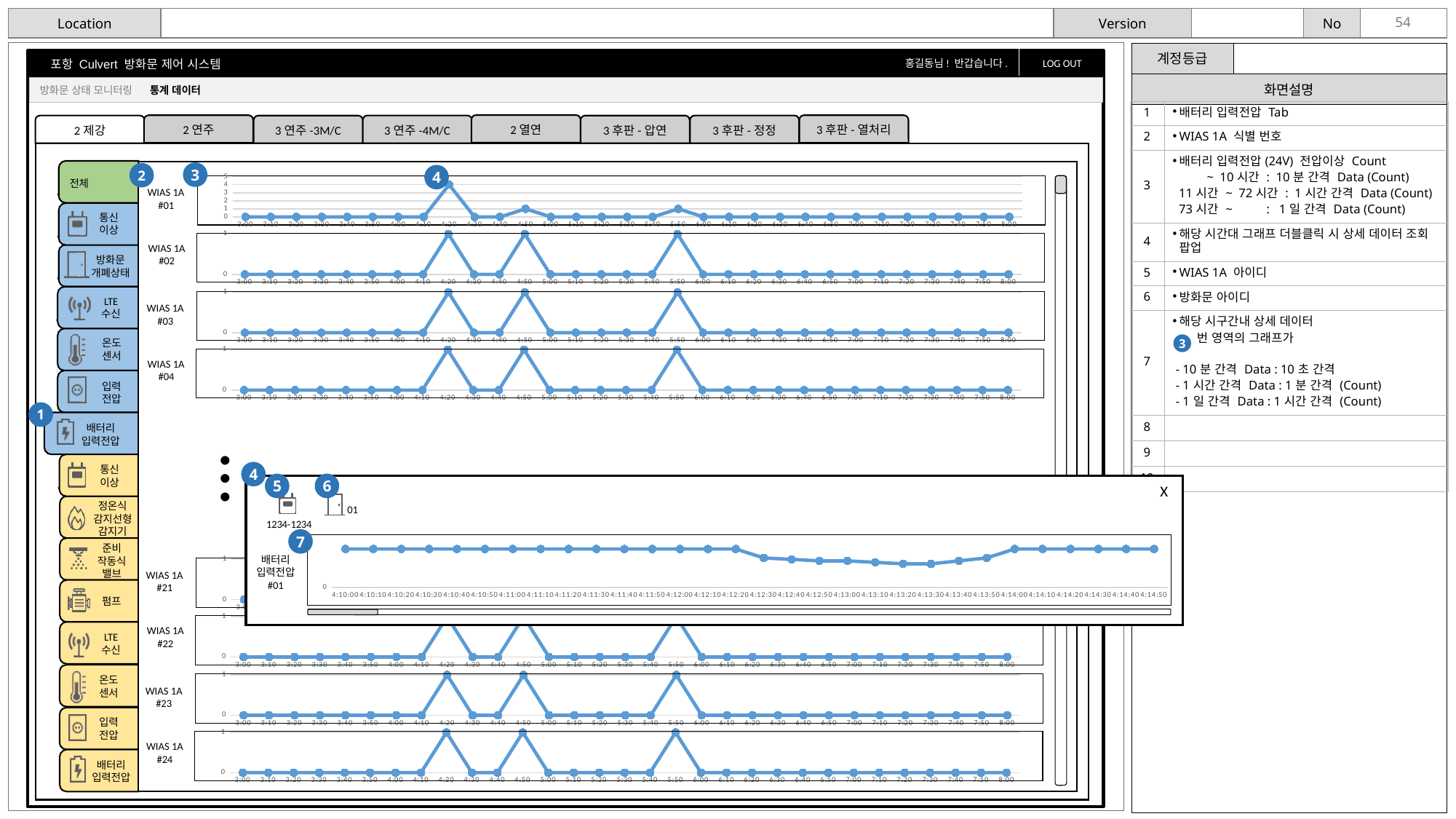
In the popup chart for 배터리 입력전압 #01, does the line rise or fall between 4:13:30 and 4:14:00? rise What is the highest y-axis tick on the WIAS 1A #01 chart? 5 How many peaks above 0 are there in the WIAS 1A #03 chart? 3 In the WIAS 1A #01 chart, at which time does the highest peak occur? 4:20 How many WIAS 1A charts are labeled on the slide? 8 In the WIAS 1A #24 chart, what is the value at 8:00? 0 In the WIAS 1A #22 chart, which is larger, the value at 4:20 or the value at 4:30? 4:20 What kind of chart is used for WIAS 1A #02? line chart In the popup chart for 배터리 입력전압 #01, does the line rise or fall between 4:12:10 and 4:13:00? fall In the WIAS 1A #02 chart, what is the value at 3:00? 0 What is the first x-axis label on the popup chart for 배터리 입력전압 #01? 4:10:00 In the WIAS 1A #01 chart, is the value at 4:20 greater or less than 3? greater